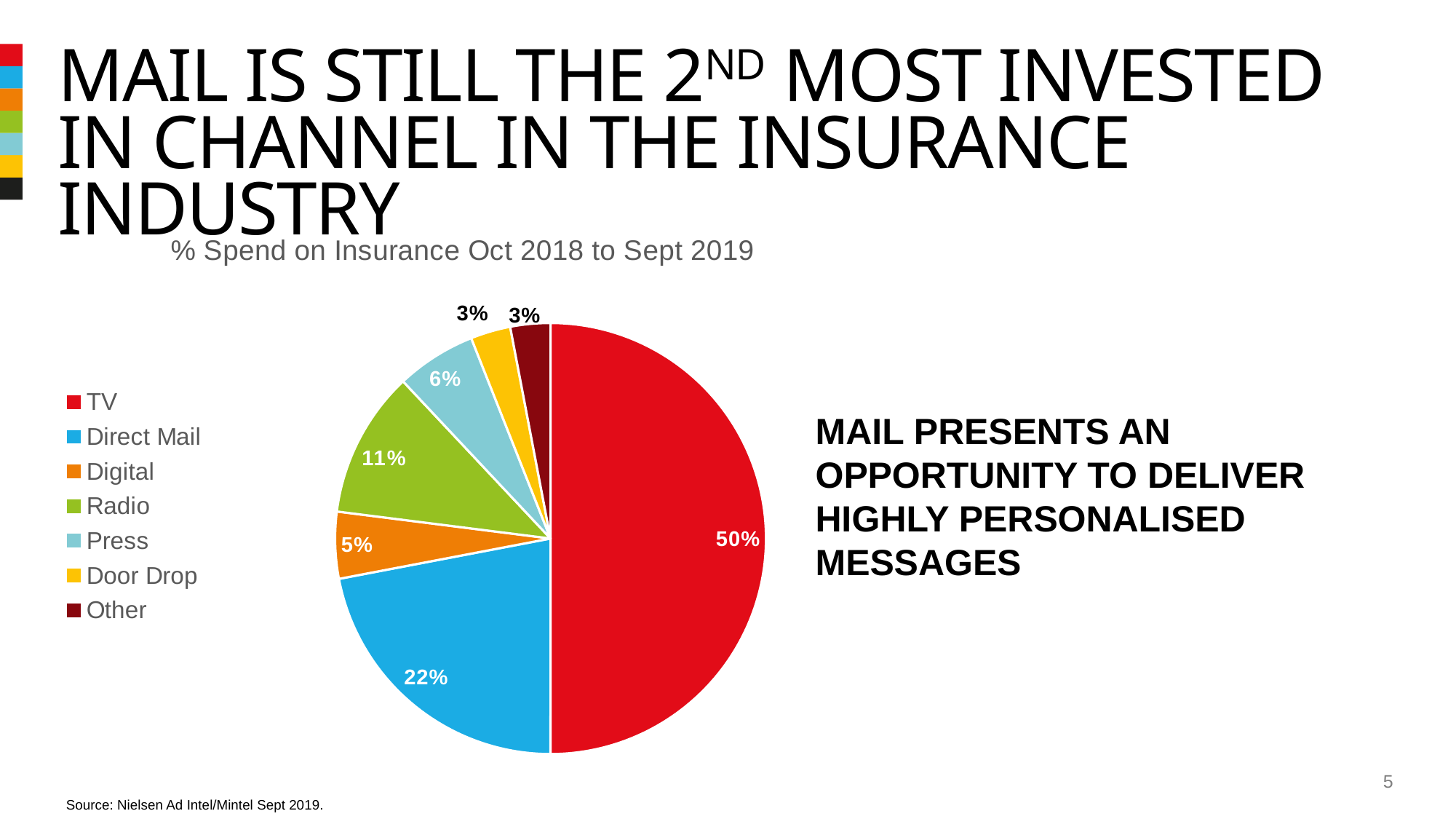
What is the difference in share between TV and Direct Mail? 28% What share of insurance spend does TV account for? 50% Which has a larger share of spend, Radio or Press? Radio What colour represents Direct Mail in the pie chart? Blue Which channel has the largest share of insurance spend? TV What share of insurance spend does Radio account for? 11% What is the title of the chart? % Spend on Insurance Oct 2018 to Sept 2019 What type of chart is shown on the slide? Pie chart What share of insurance spend does Direct Mail account for? 22% How many channels are listed in the chart legend? 7 What share of insurance spend does Digital account for? 5% What share of insurance spend does Press account for? 6%